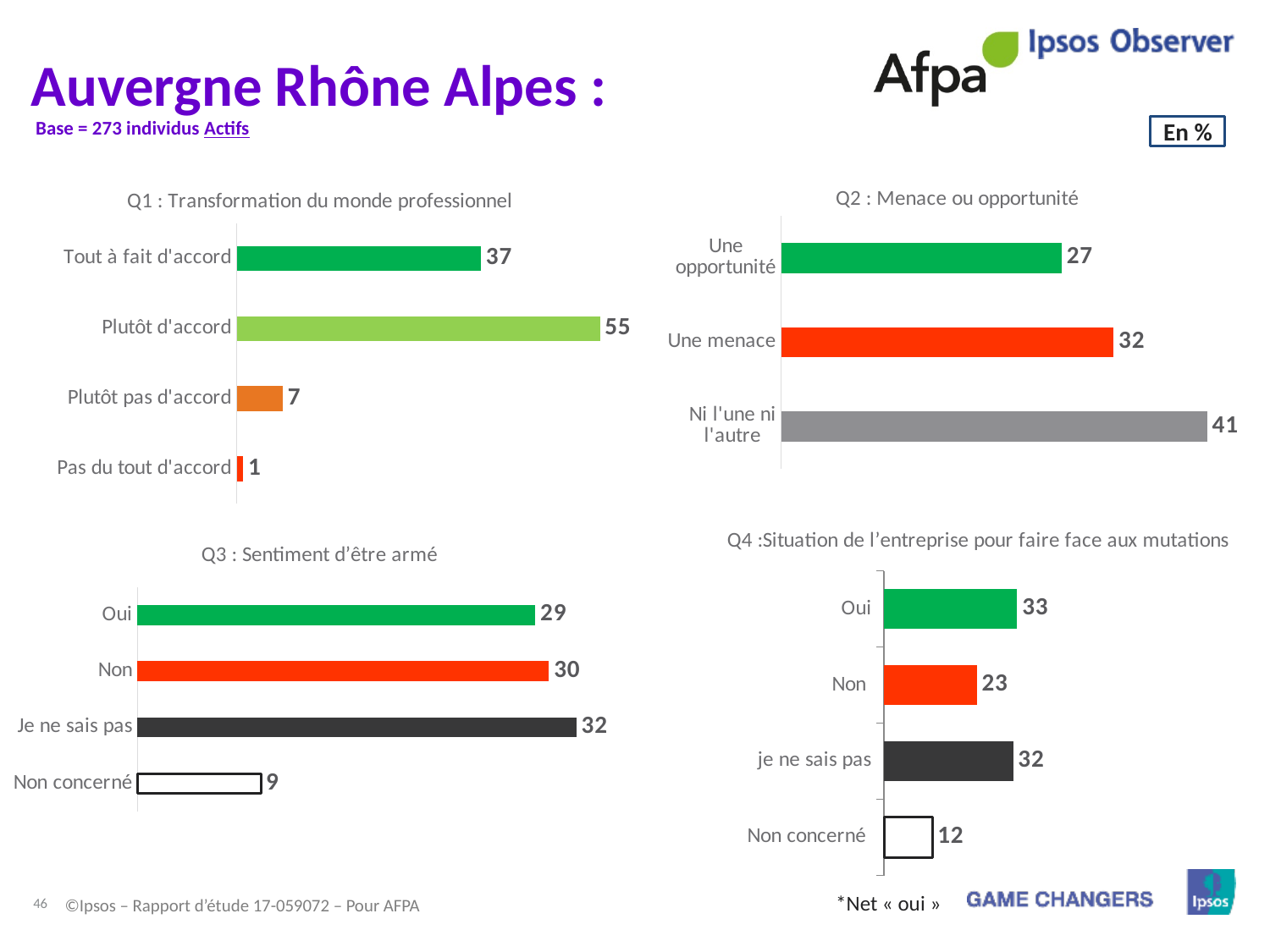
In the Q1 : Transformation du monde professionnel chart, what is the value for Plutôt d'accord? 55 What kind of chart is the Q1 : Transformation du monde professionnel chart? Bar chart In the Q1 : Transformation du monde professionnel chart, what is the difference between Plutôt d'accord and Tout à fait d'accord? 18 In the Q2 : Menace ou opportunité chart, which is larger, Une opportunité or Une menace? Une menace In the Q2 : Menace ou opportunité chart, which category has the highest value? Ni l'une ni l'autre In the Q3 : Sentiment d'être armé chart, how many categories are shown? 4 In the Q3 : Sentiment d'être armé chart, what is the value for Non concerné? 9 In the Q2 : Menace ou opportunité chart, what is the value for Une menace? 32 In the Q1 : Transformation du monde professionnel chart, which category has the lowest value? Pas du tout d'accord In the Q4 : Situation de l'entreprise pour faire face aux mutations chart, what is the value for Non? 23 In the Q3 : Sentiment d'être armé chart, which category has the highest value? Je ne sais pas In the Q4 : Situation de l'entreprise pour faire face aux mutations chart, what is the difference between Oui and Non concerné? 21